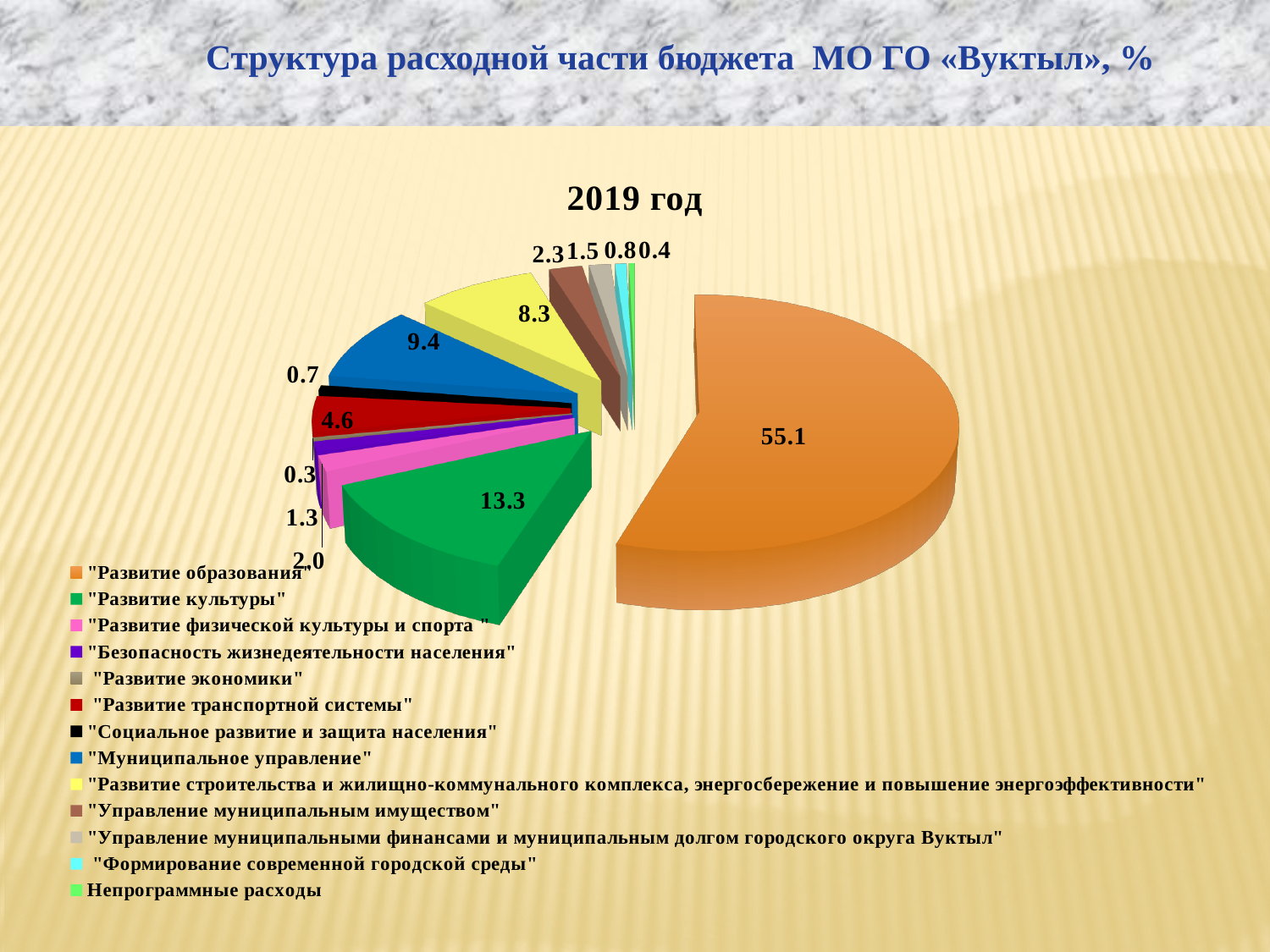
Which category has the largest share of the pie? "Развитие образования" What is the value for "Развитие культуры"? 13.3 What is the value for "Муниципальное управление"? 9.4 What is the value for "Развитие транспортной системы"? 4.6 What kind of chart is shown on the slide? pie chart What is the value for "Развитие строительства и жилищно-коммунального комплекса, энергосбережение и повышение энергоэффективности"? 8.3 How many categories does the legend list? 13 What is the difference between the values for "Развитие образования" and "Развитие культуры"? 41.8 What is the value for "Управление муниципальным имуществом"? 2.3 Which is larger, the value for "Муниципальное управление" or the value for "Развитие транспортной системы"? "Муниципальное управление" What is the title shown above the pie chart? 2019 год What is the value for "Развитие образования"? 55.1